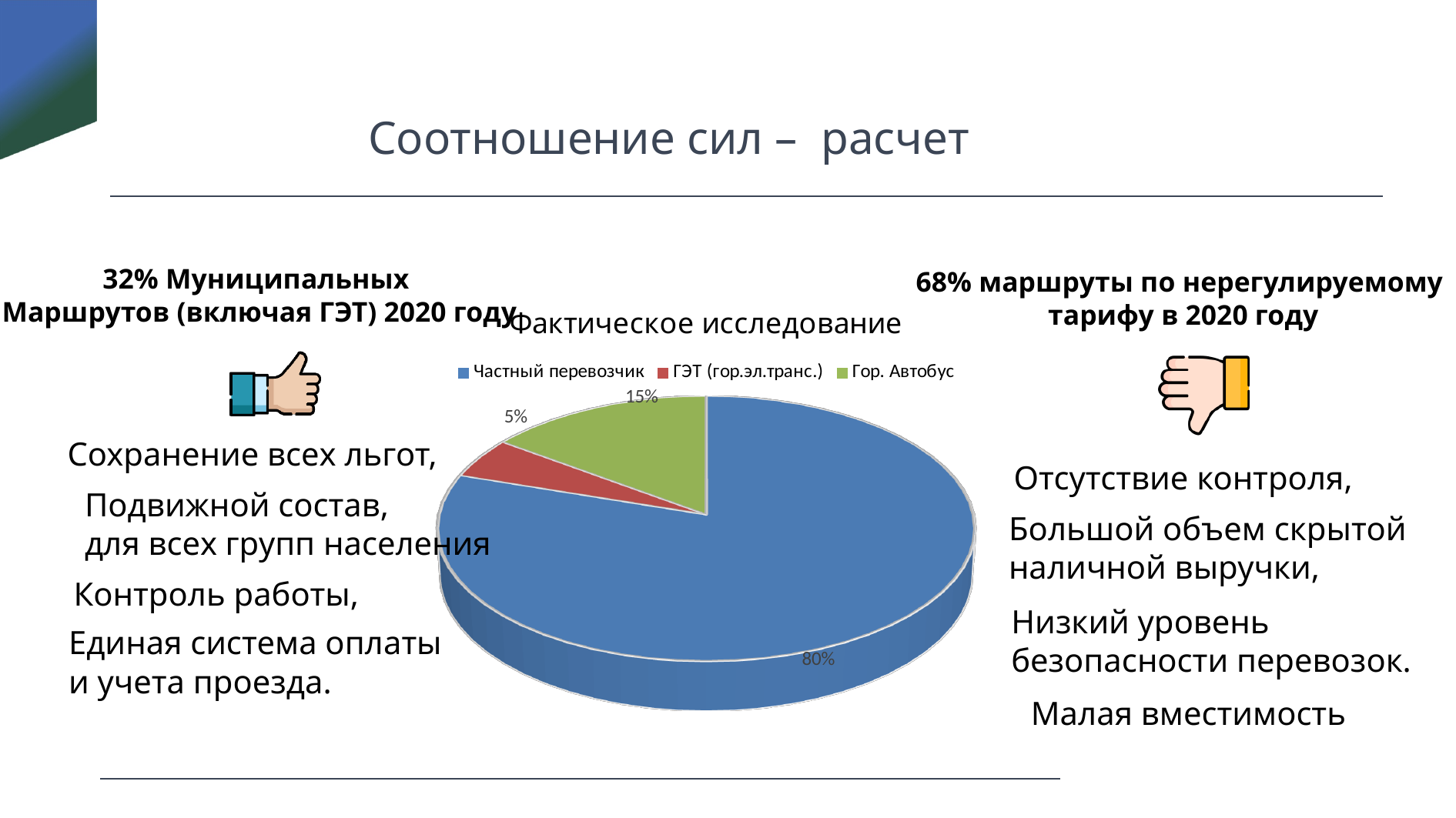
Which category has the largest slice of the pie? Частный перевозчик What share of the pie does Частный перевозчик have? 80% How many entries does the chart legend list? 3 What colour is the slice for Гор. Автобус? Green What is the title of the chart? Фактическое исследование Which is larger: the share for Гор. Автобус or the share for ГЭТ (гор.эл.транс.)? Гор. Автобус How many slices does the pie chart have? 3 Which category has the smallest slice of the pie? ГЭТ (гор.эл.транс.) What share of the pie does ГЭТ (гор.эл.транс.) have? 5% What share of the pie does Гор. Автобус have? 15% What type of chart is shown on the slide? Pie chart What is the difference in percentage points between Частный перевозчик and Гор. Автобус? 65